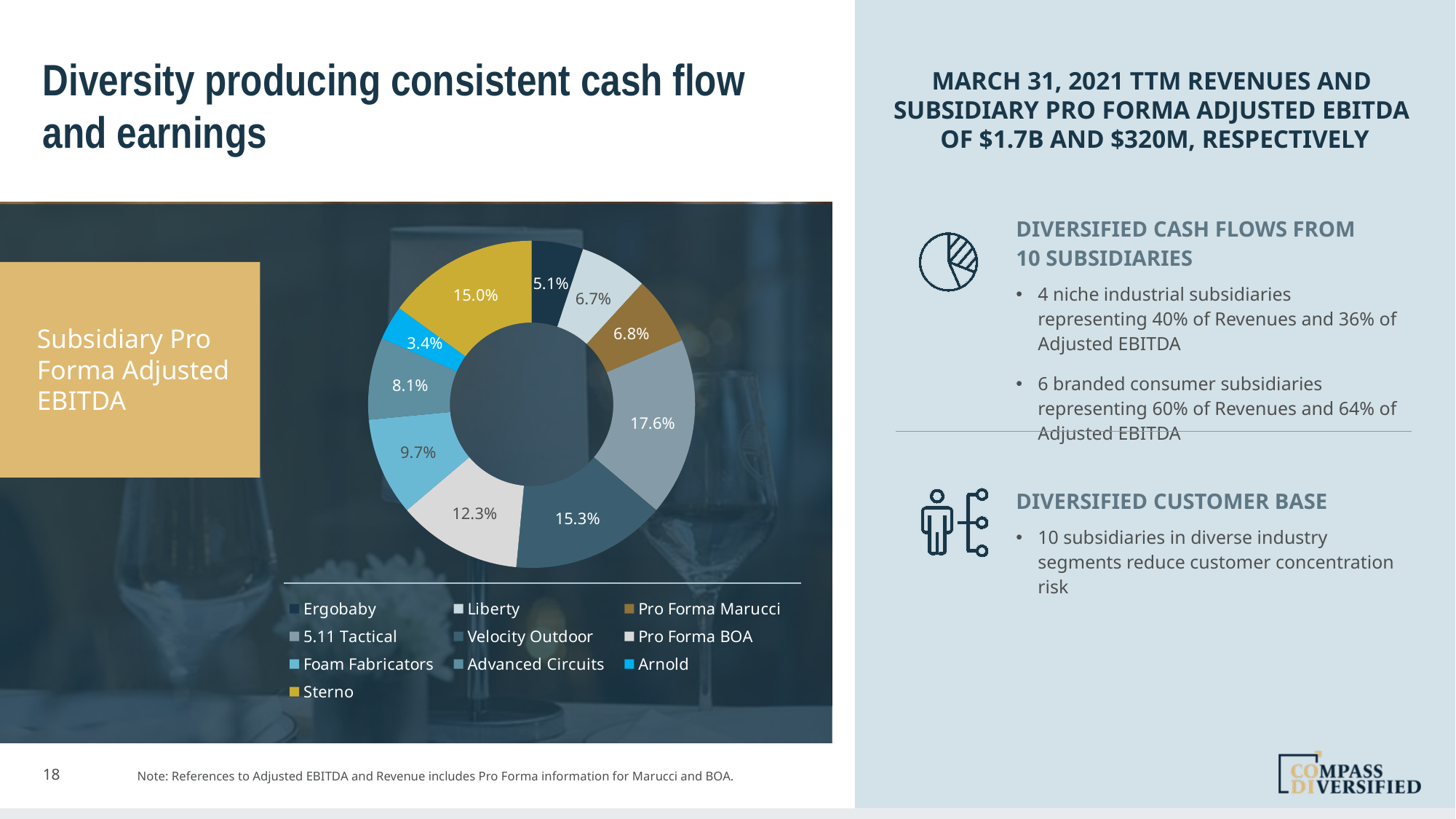
Which subsidiary has the largest share of Subsidiary Pro Forma Adjusted EBITDA? 5.11 Tactical What kind of chart is shown on the slide? Pie chart (donut) What share of Subsidiary Pro Forma Adjusted EBITDA does Sterno represent? 15.0% How many subsidiaries are listed in the legend of the Subsidiary Pro Forma Adjusted EBITDA chart? 10 What is the title shown next to the pie chart? Subsidiary Pro Forma Adjusted EBITDA Which has a larger share of Subsidiary Pro Forma Adjusted EBITDA, Sterno or Pro Forma BOA? Sterno What is the difference between the largest slice (17.6%) and the smallest slice (3.4%) in the chart? 14.2% What is the difference between the shares of Velocity Outdoor (15.3%) and Foam Fabricators (9.7%)? 5.6% What share of Subsidiary Pro Forma Adjusted EBITDA does Pro Forma Marucci represent? 6.8% What share of Subsidiary Pro Forma Adjusted EBITDA does Ergobaby represent? 5.1% What share of Subsidiary Pro Forma Adjusted EBITDA does Arnold represent? 3.4% Which subsidiary has the smallest share of Subsidiary Pro Forma Adjusted EBITDA? Arnold